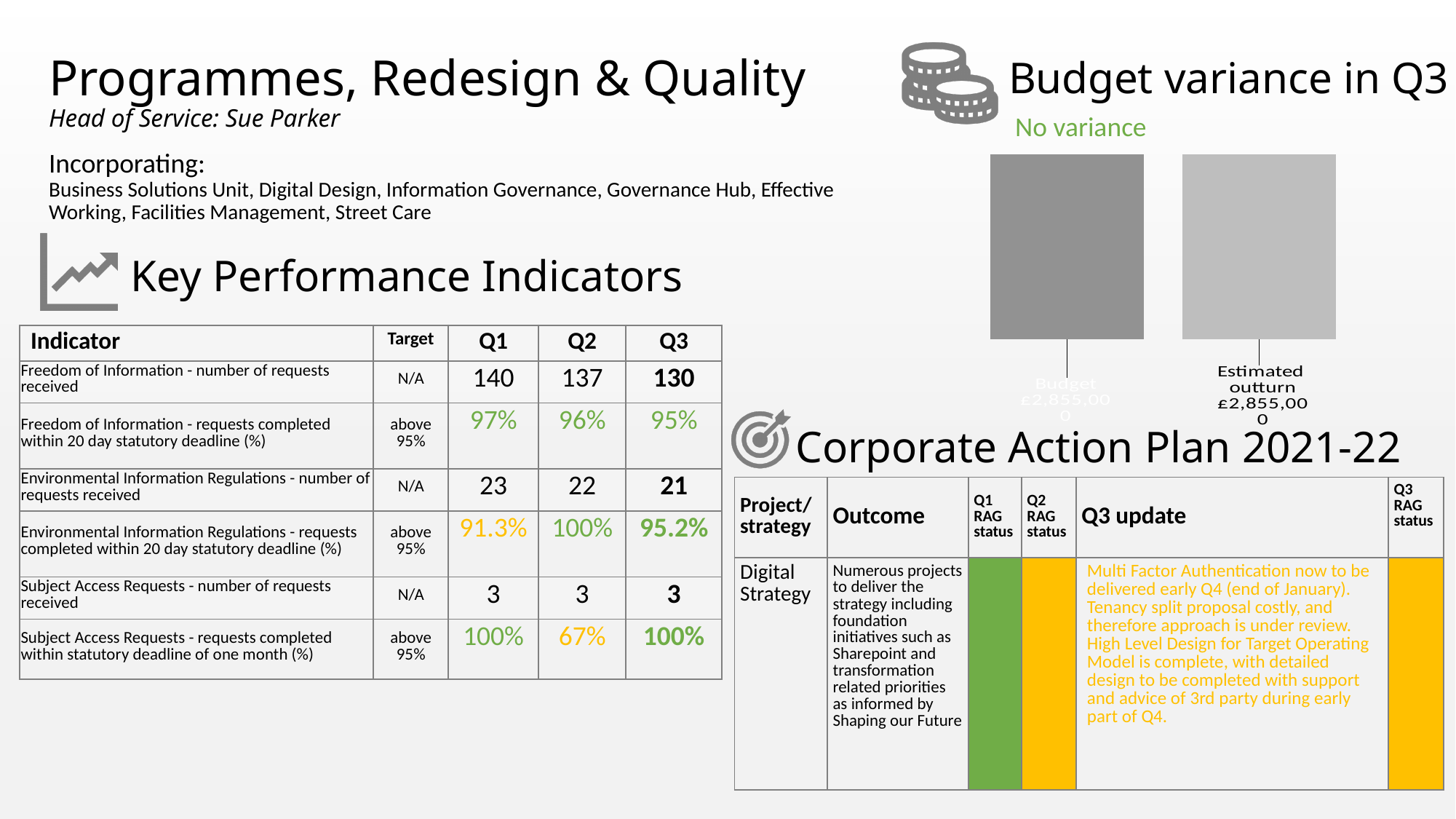
What kind of chart is shown under the 'Budget variance in Q3' heading? Bar chart What are the two categories labelled on the 'Budget variance in Q3' chart? Budget and Estimated outturn What text in green appears directly under the 'Budget variance in Q3' heading? No variance In the 'Budget variance in Q3' chart, is the Estimated outturn larger than, smaller than, or equal to the Budget? Equal How many bars does the 'Budget variance in Q3' chart have? 2 In the 'Budget variance in Q3' chart, what is the difference between the Budget and the Estimated outturn? £0 In the 'Budget variance in Q3' chart, what is the value of the Estimated outturn bar? £2,855,000 In the 'Budget variance in Q3' chart, what is the value of the Budget bar? £2,855,000